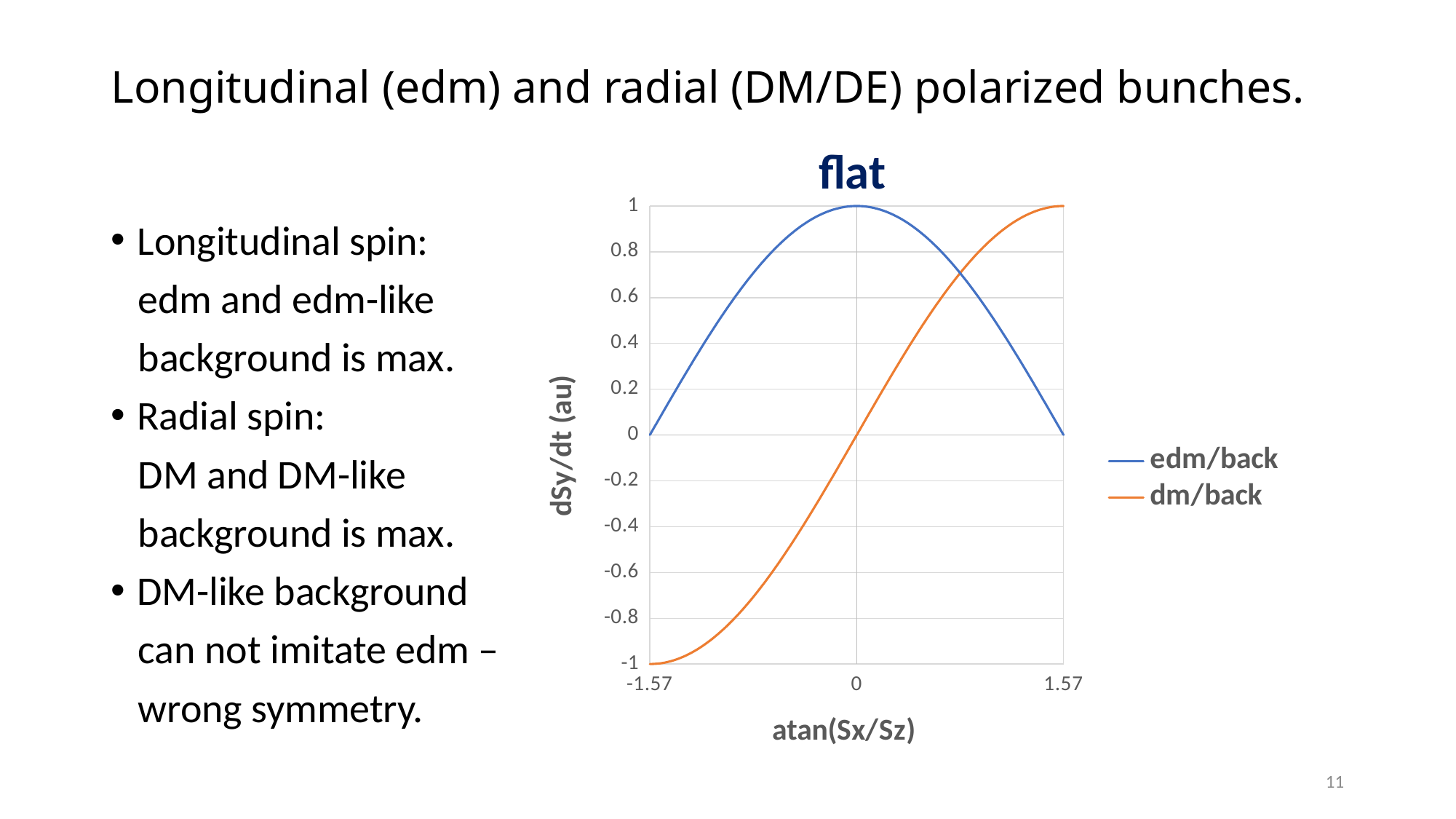
What type of chart is shown on the slide? line chart What is the value of the dm/back series at atan(Sx/Sz) = 0? 0 What is the value of the dm/back series at atan(Sx/Sz) = -1.57? -1 What is the difference between the dm/back value at atan(Sx/Sz) = 1.57 and its value at atan(Sx/Sz) = -1.57? 2 At atan(Sx/Sz) = -1.57, which series has the larger value, edm/back or dm/back? edm/back What is the value of the dm/back series at atan(Sx/Sz) = 1.57? 1 What is the value of the edm/back series at atan(Sx/Sz) = 1.57? 0 Does the dm/back series rise or fall as atan(Sx/Sz) increases from -1.57 to 1.57? rise How many series does the chart legend list? 2 What is the label of the y axis? dSy/dt (au) What is the value of the edm/back series at atan(Sx/Sz) = 0? 1 What is the title of the chart? flat